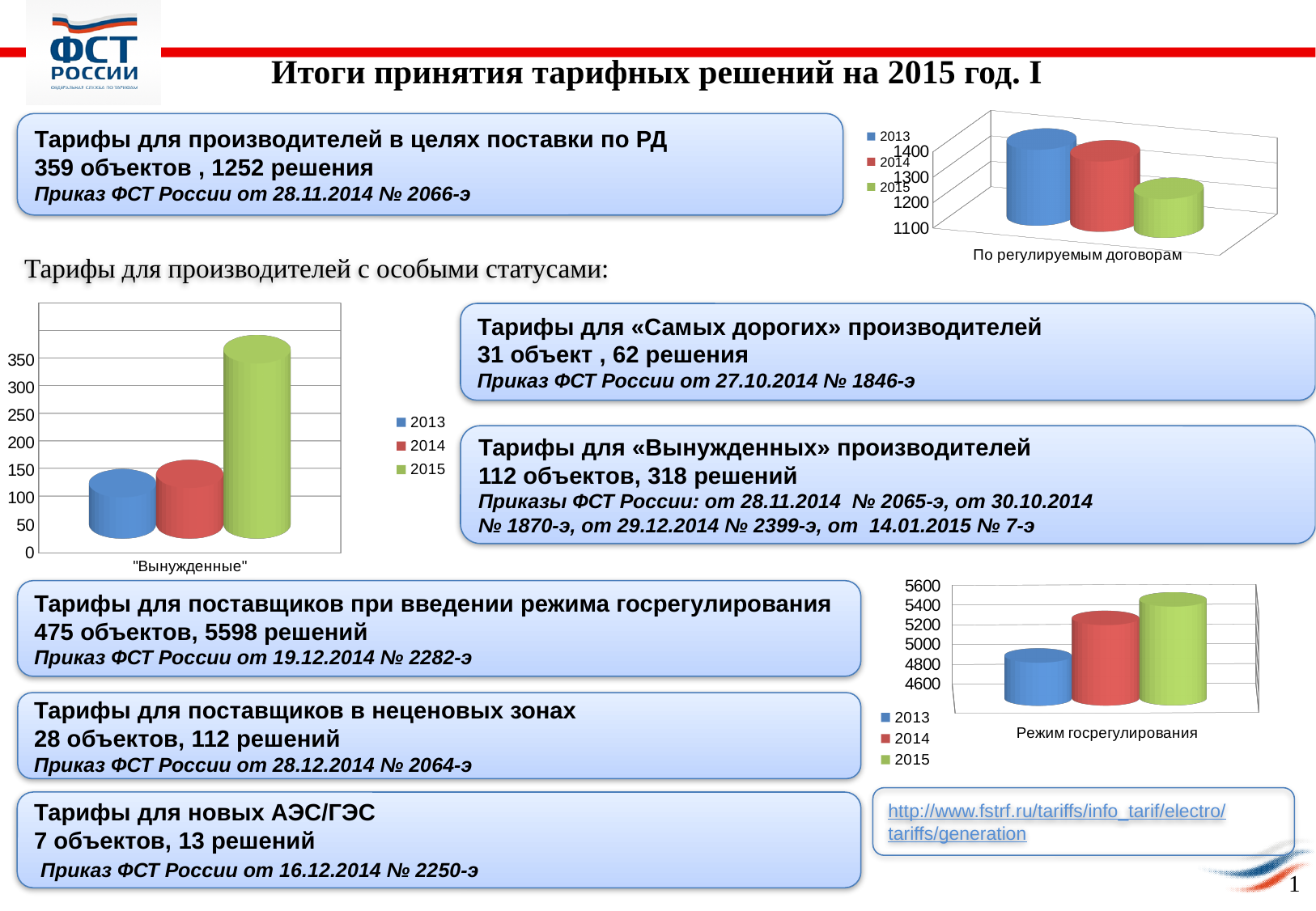
In the chart titled "Вынужденные", is the value for 2013 greater or less than 150? less In the chart titled "По регулируемым договорам", do the values rise or fall from 2013 to 2015? fall In the chart titled "Вынужденные", which year has the highest value? 2015 In the chart titled "По регулируемым договорам", which year has the lowest value? 2015 In the chart titled "Режим госрегулирования", which year has the lowest value? 2013 In the chart titled "Вынужденные", is the value for 2015 greater or less than 300? greater In the chart titled "Вынужденные", how many series does the legend list? 3 In the chart titled "Вынужденные", which year has the lowest value? 2013 What kind of chart is the chart titled "По регулируемым договорам"? bar chart In the chart titled "Режим госрегулирования", which year has the highest value? 2015 In the chart titled "Режим госрегулирования", do the values rise or fall from 2013 to 2015? rise